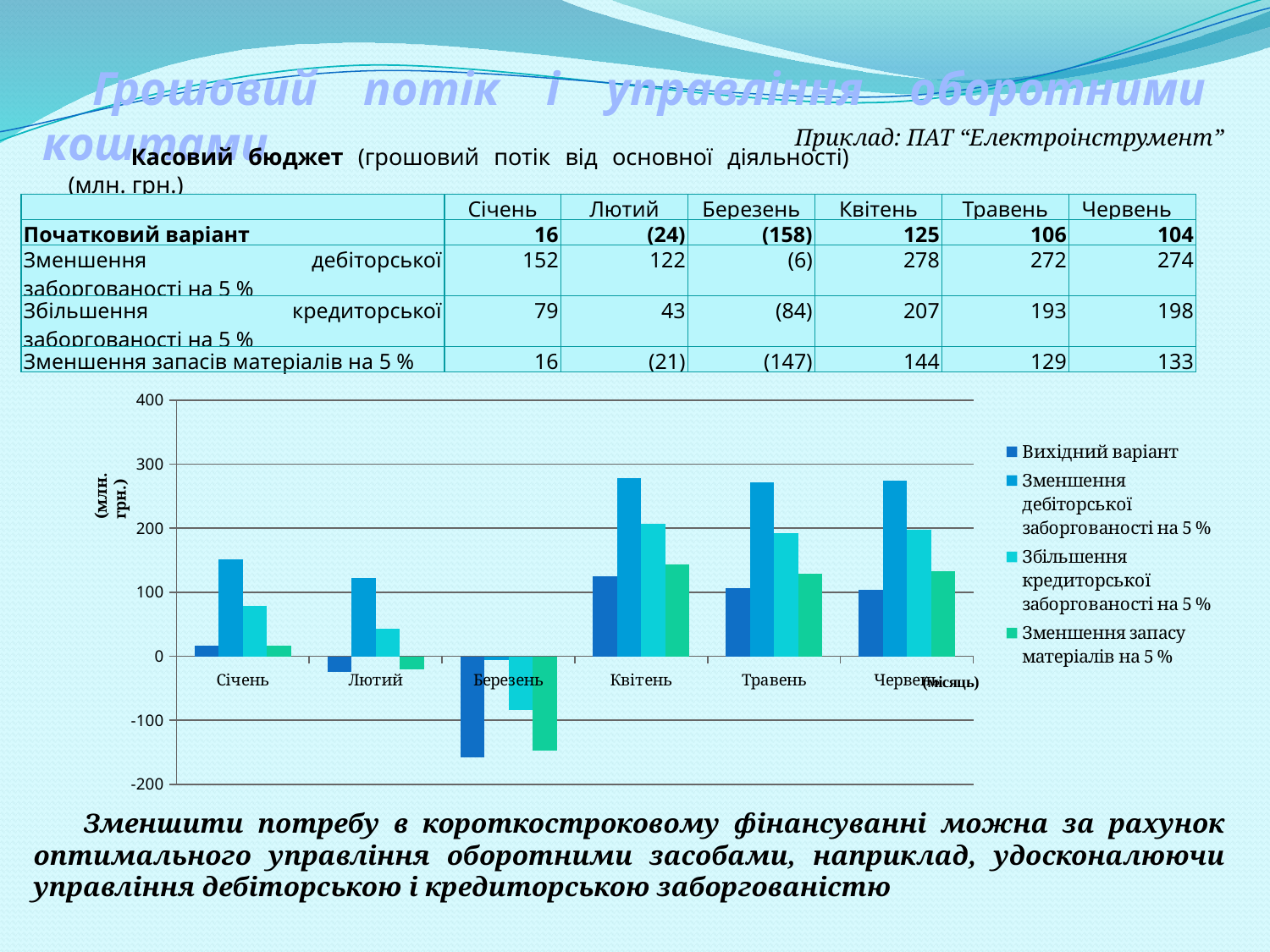
Is the value for Січень in the 'Вихідний варіант' series greater or less than 100? less For Лютий, which is larger: the 'Зменшення дебіторської заборгованості на 5 %' bar or the 'Збільшення кредиторської заборгованості на 5 %' bar? Зменшення дебіторської заборгованості на 5 % According to the table, what is the value for Березень in the 'Початковий варіант' row? (158) How many months are shown along the x axis of the chart? 6 What unit label is shown on the y axis of the chart? (млн. грн.) What kind of chart is shown on the slide? bar chart According to the table, what is the value for Квітень in the 'Зменшення дебіторської заборгованості на 5 %' row? 278 How many series does the chart legend list? 4 Using the table values, what is the difference between 'Зменшення запасів матеріалів на 5 %' (144) and 'Початковий варіант' (125) for Квітень? 19 In the chart, which series has the highest bar for Квітень? Зменшення дебіторської заборгованості на 5 % Is the value for Травень in the 'Зменшення дебіторської заборгованості на 5 %' series greater or less than 200? greater In the chart, which month has the lowest bar for the 'Вихідний варіант' series? Березень